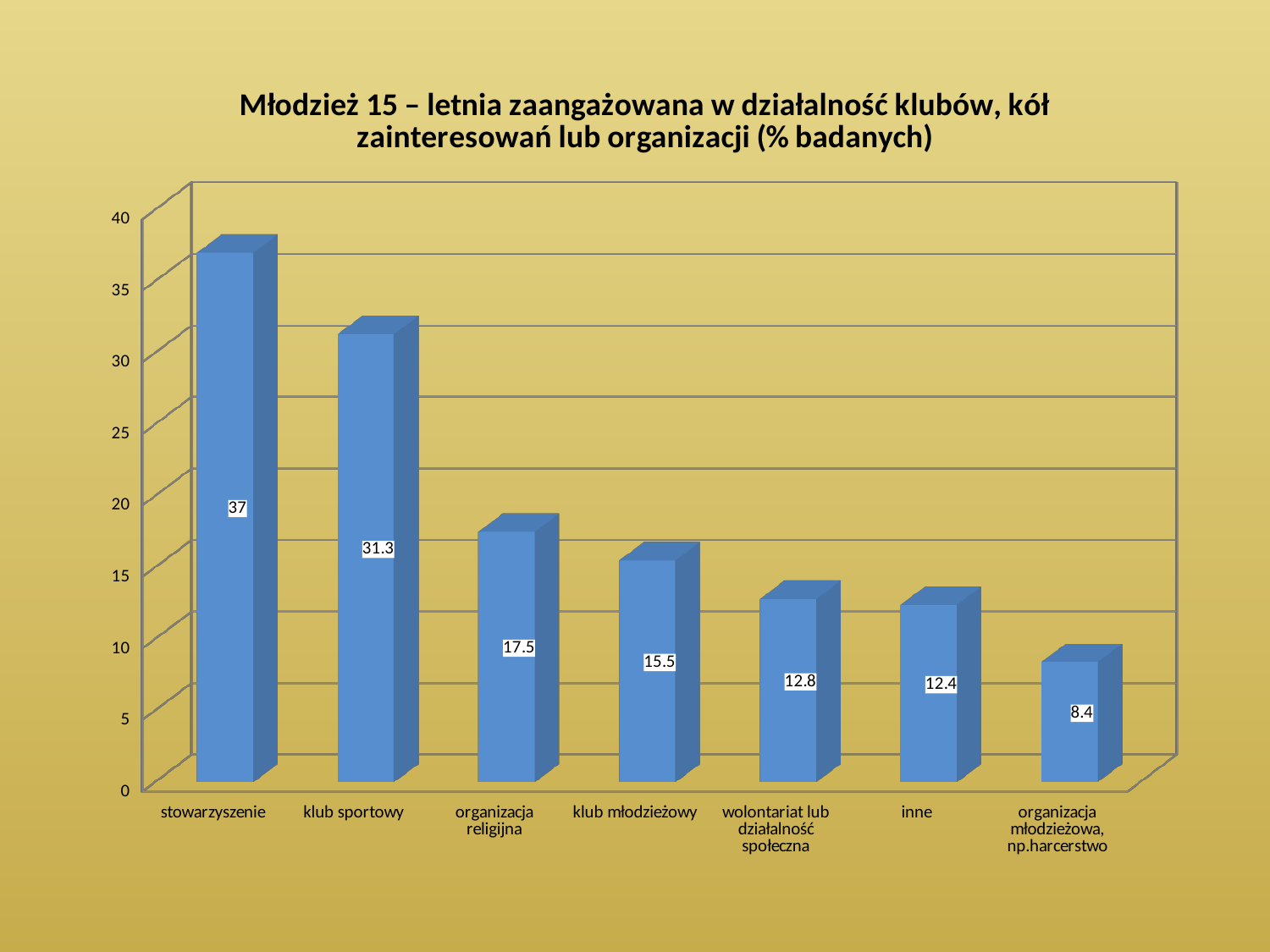
What is the value for klub sportowy? 31.3 How many categories are shown on the x axis? 7 What is the value for organizacja religijna? 17.5 Which is larger, the value for organizacja religijna or the value for klub młodzieżowy? organizacja religijna What is the difference between the values for stowarzyszenie and klub sportowy? 5.7 Which category has the lowest value? organizacja młodzieżowa, np.harcerstwo What is the difference between the values for klub młodzieżowy and organizacja młodzieżowa, np.harcerstwo? 7.1 What is the value for stowarzyszenie? 37 What is the value for wolontariat lub działalność społeczna? 12.8 Do the values rise or fall from left to right along the x axis? fall Which category has the highest value? stowarzyszenie What kind of chart is this? bar chart